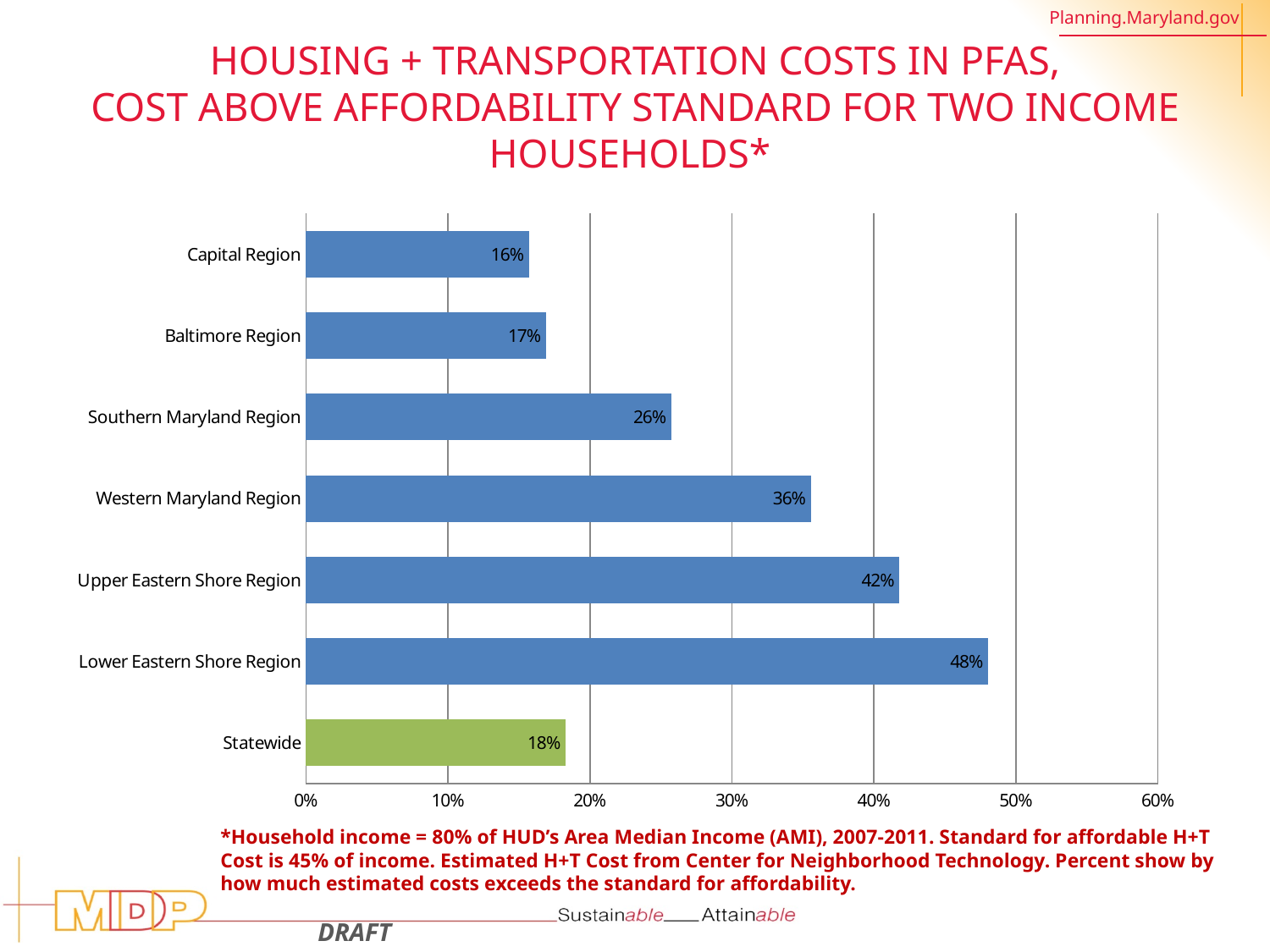
What is the value for the Western Maryland Region? 36% Which is larger, the value for the Western Maryland Region or the Southern Maryland Region? Western Maryland Region What is the value for the Capital Region? 16% What kind of chart is shown on the slide? Bar chart Which region has the highest value? Lower Eastern Shore Region What is the difference between the Southern Maryland Region and the Baltimore Region? 9% How many categories are shown in the chart? 7 What is the Statewide value? 18% Which category has the lowest value? Capital Region Which bar is shown in a different colour (green) from the others? Statewide Is the value for the Upper Eastern Shore Region greater or less than 40%? greater What is the difference between the Lower Eastern Shore Region and the Upper Eastern Shore Region? 6%